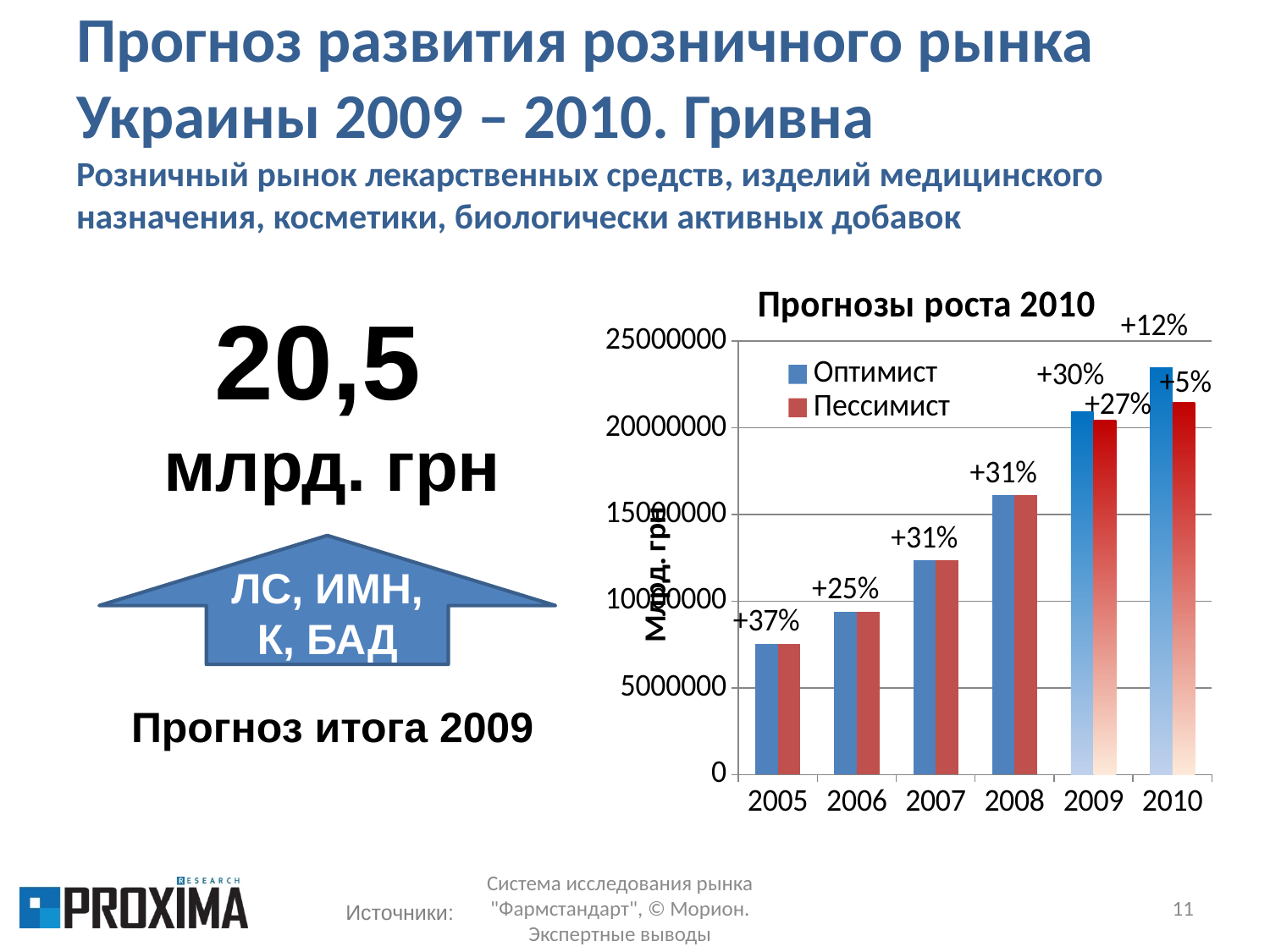
In the "Прогнозы роста 2010" chart, is the Оптимист value for 2005 greater or less than 10000000? less What growth percentage label is shown above the 2006 bars in the "Прогнозы роста 2010" chart? +25% How many series does the legend of the "Прогнозы роста 2010" chart list? 2 In the "Прогнозы роста 2010" chart, is the Пессимист value for 2007 greater or less than 15000000? less How many years are shown on the x axis of the "Прогнозы роста 2010" chart? 6 In the "Прогнозы роста 2010" chart, which year has the lowest Оптимист value? 2005 In the "Прогнозы роста 2010" chart, which year has the highest Оптимист value? 2010 In the "Прогнозы роста 2010" chart, is the Оптимист value for 2010 greater or less than 20000000? greater What kind of chart is "Прогнозы роста 2010"? bar chart In the "Прогнозы роста 2010" chart, do the Оптимист values rise or fall from 2005 to 2010? rise In the "Прогнозы роста 2010" chart, which series has the larger value for 2010, Оптимист or Пессимист? Оптимист